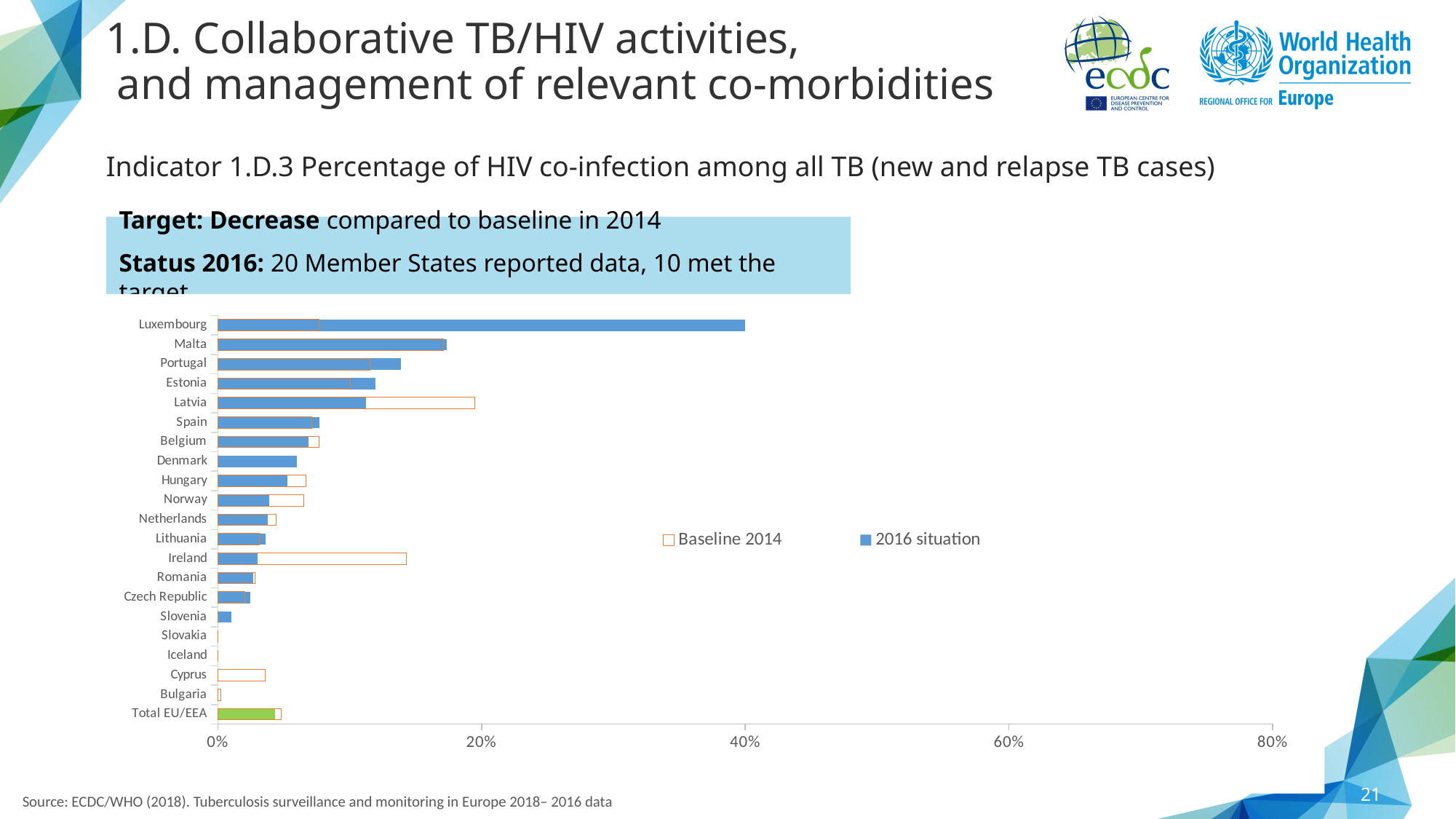
For Latvia, which is larger: the Baseline 2014 value or the 2016 situation value? Baseline 2014 What are the two series named in the chart legend? Baseline 2014 and 2016 situation Is the 2016 situation value for Malta greater or less than 20%? less For Luxembourg, which is larger: the Baseline 2014 value or the 2016 situation value? 2016 situation How many series does the chart legend list? 2 Is the 2016 situation value for Luxembourg greater or less than 20%? greater How many categories (countries plus the EU/EEA total) are listed on the vertical axis of the chart? 21 What kind of chart is shown on the slide? Bar chart Which country has the highest 2016 situation value in the chart? Luxembourg Which country has the highest Baseline 2014 value in the chart? Latvia Which has the larger 2016 situation value: Malta or Portugal? Malta Is the Baseline 2014 value for Ireland greater or less than 20%? less